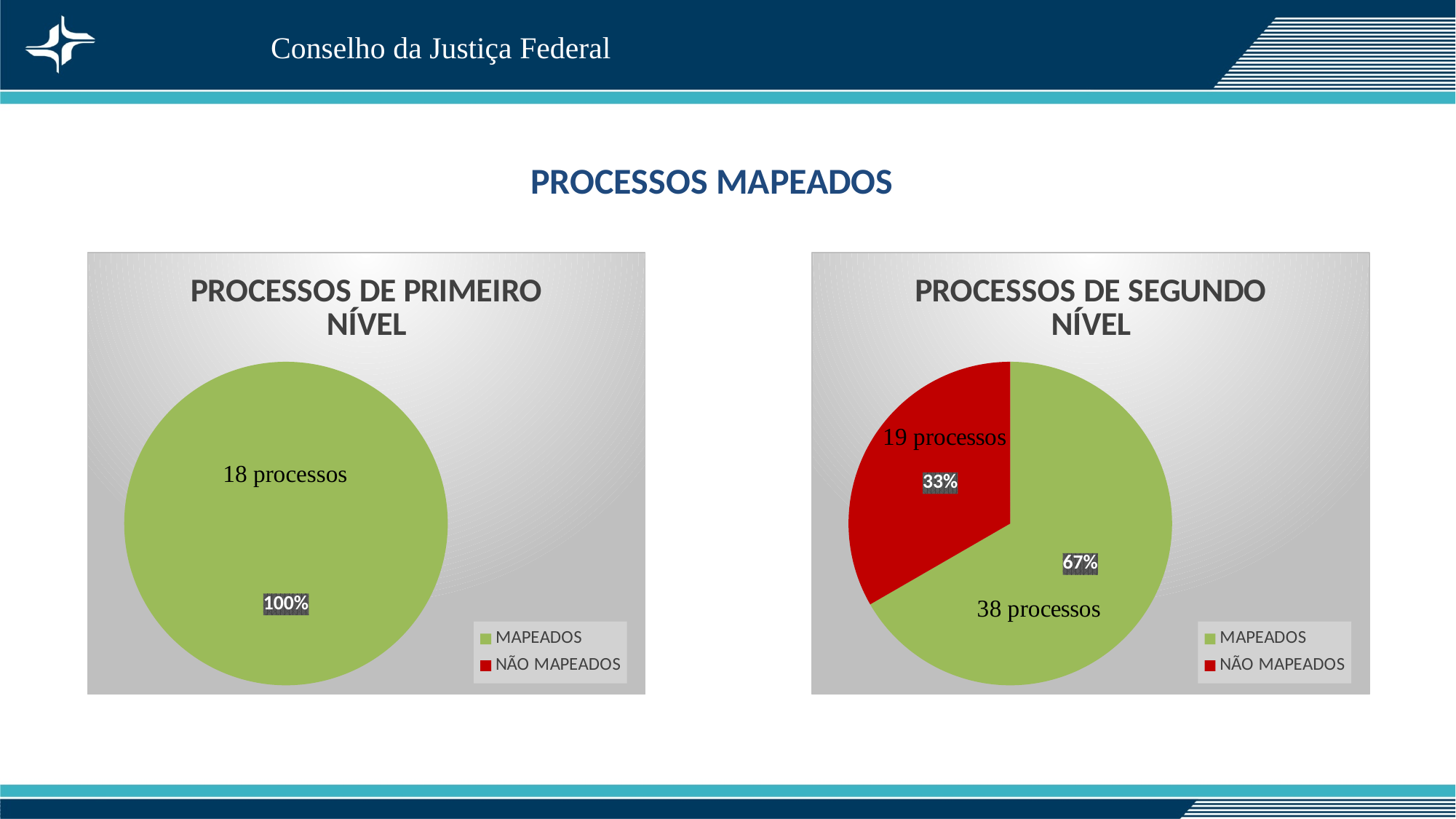
In the 'PROCESSOS DE SEGUNDO NÍVEL' chart, how many processes are labelled on the MAPEADOS slice? 38 processos In the 'PROCESSOS DE PRIMEIRO NÍVEL' chart, what percentage is shown for MAPEADOS? 100% What kind of chart is the 'PROCESSOS DE PRIMEIRO NÍVEL' chart? pie chart In the 'PROCESSOS DE SEGUNDO NÍVEL' chart, how many processes are labelled on the NÃO MAPEADOS slice? 19 processos How many series does the legend of the 'PROCESSOS DE PRIMEIRO NÍVEL' chart list? 2 What colour represents NÃO MAPEADOS in the legend of the 'PROCESSOS DE SEGUNDO NÍVEL' chart? red In the 'PROCESSOS DE SEGUNDO NÍVEL' chart, what percentage is shown for NÃO MAPEADOS? 33% In the 'PROCESSOS DE SEGUNDO NÍVEL' chart, what is the difference in number of processes between MAPEADOS and NÃO MAPEADOS? 19 In the 'PROCESSOS DE PRIMEIRO NÍVEL' chart, how many processes are labelled on the MAPEADOS slice? 18 processos In the 'PROCESSOS DE SEGUNDO NÍVEL' chart, what percentage is shown for MAPEADOS? 67% In the 'PROCESSOS DE SEGUNDO NÍVEL' chart, which slice is larger, MAPEADOS or NÃO MAPEADOS? MAPEADOS In the 'PROCESSOS DE SEGUNDO NÍVEL' chart, what is the total number of processes across both slices? 57